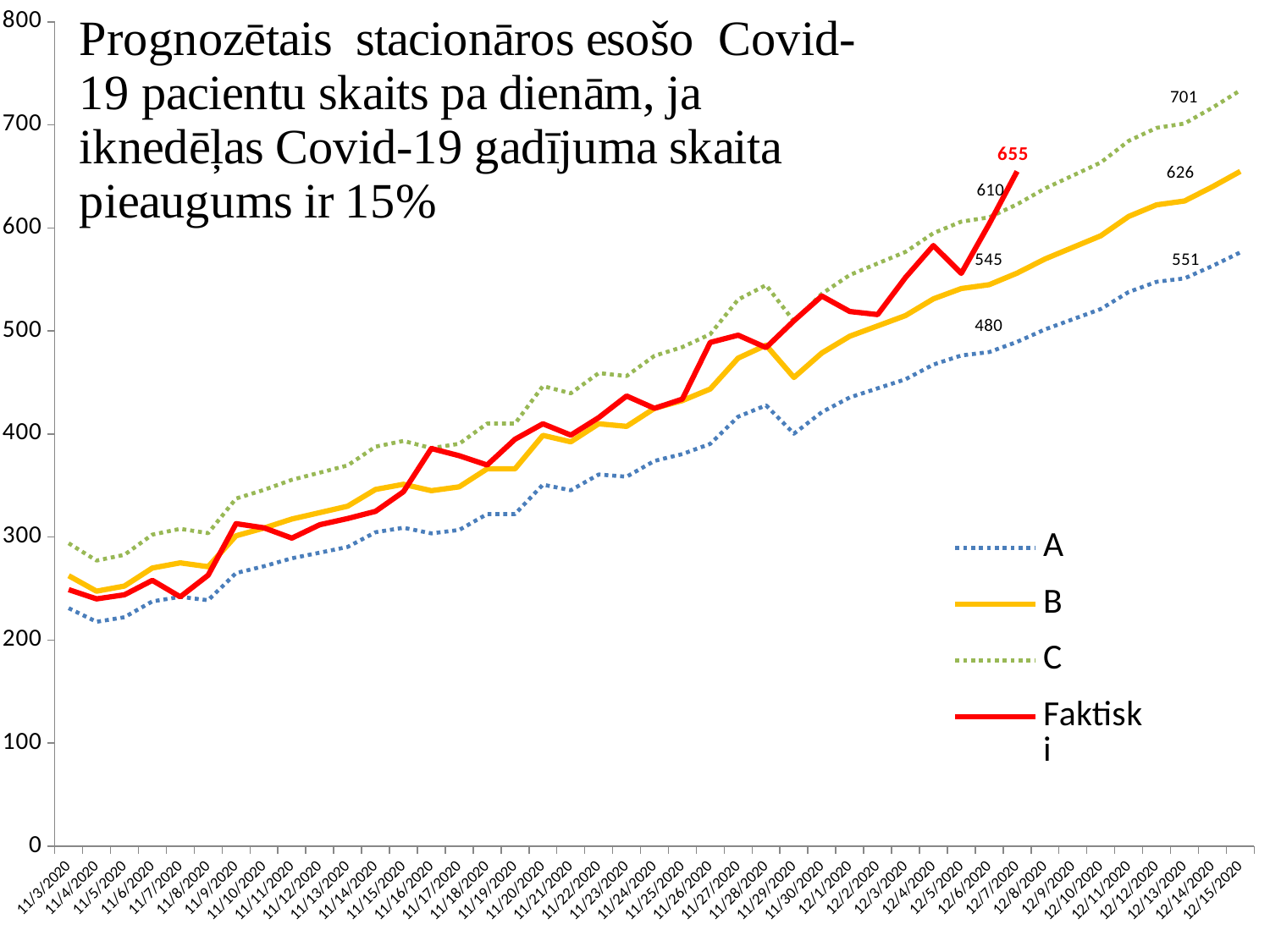
What is the labelled value of series C on 12/13/2020? 701 What kind of chart is shown on the slide? line chart Which series has the highest value on 12/15/2020? C Which series has the lowest value on 12/15/2020? A Do the values of series B rise or fall from 11/3/2020 to 12/15/2020? rise Is the value of series C on 12/15/2020 greater or less than 700? greater What is the labelled value of series B on 12/13/2020? 626 On 12/13/2020, what is the difference between the labelled values of series C (701) and series A (551)? 150 What is the last labelled value of the Faktiski series, on 12/7/2020? 655 What is the labelled value of series A on 12/13/2020? 551 How many series does the legend list? 4 Is the value of series A on 11/3/2020 greater or less than 300? less